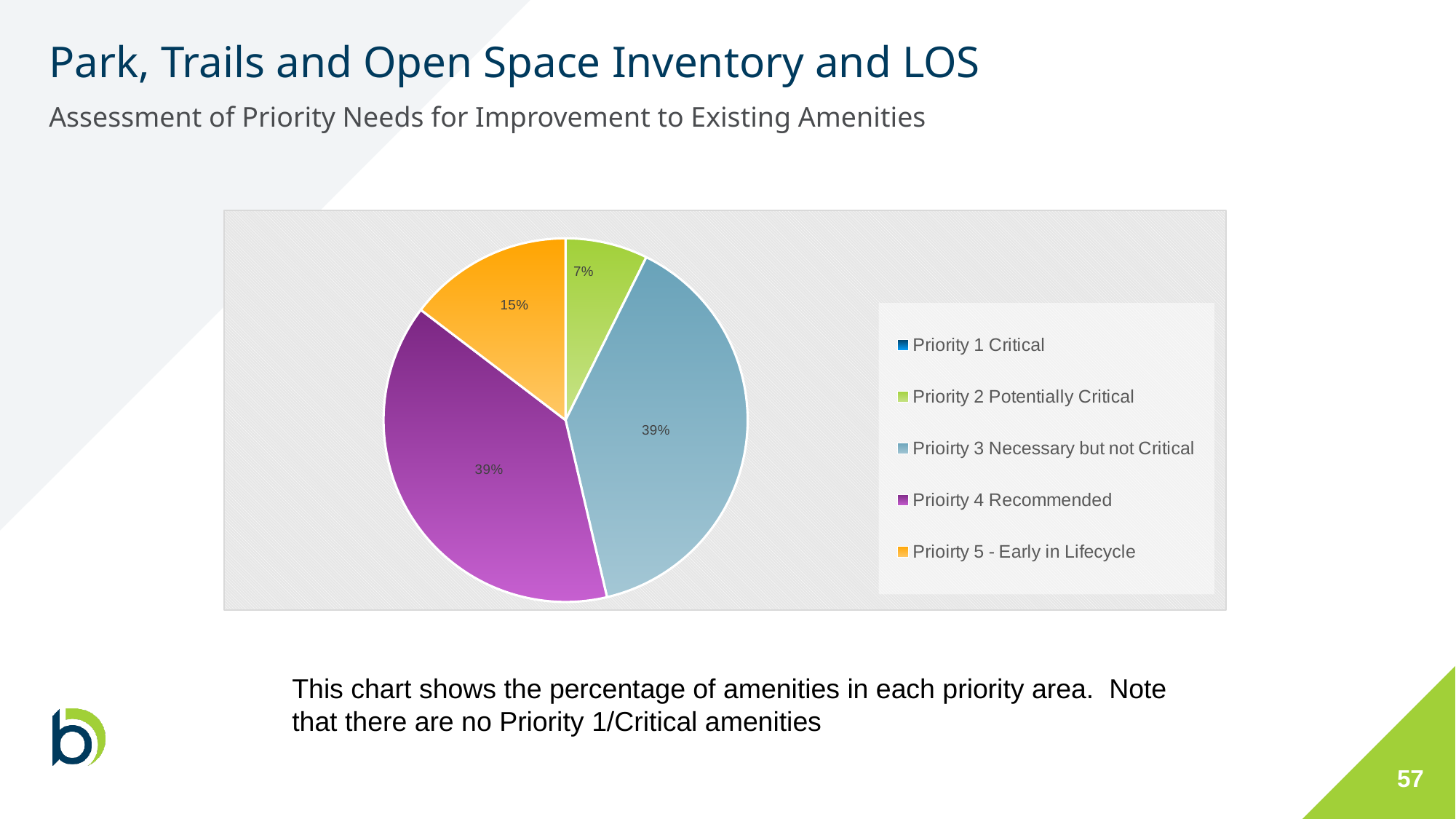
What colour is the Prioirty 5 - Early in Lifecycle slice? Orange How many slices are visible in the pie chart? 4 How many entries does the chart legend list? 5 What percentage of amenities fall under Priority 2 Potentially Critical? 7% Which slice shown on the pie is the smallest? Priority 2 Potentially Critical What share of the pie does Prioirty 3 Necessary but not Critical take? 39% What share of the pie does Prioirty 4 Recommended take? 39% What percentage of amenities fall under Prioirty 5 - Early in Lifecycle? 15% Which is larger, the slice for Prioirty 5 - Early in Lifecycle or the slice for Priority 2 Potentially Critical? Prioirty 5 - Early in Lifecycle What is the difference in percentage points between the Prioirty 4 Recommended slice and the Priority 2 Potentially Critical slice? 32 percentage points What is the difference in percentage points between the Prioirty 5 - Early in Lifecycle slice and the Priority 2 Potentially Critical slice? 8 percentage points What type of chart is shown on the slide? Pie chart